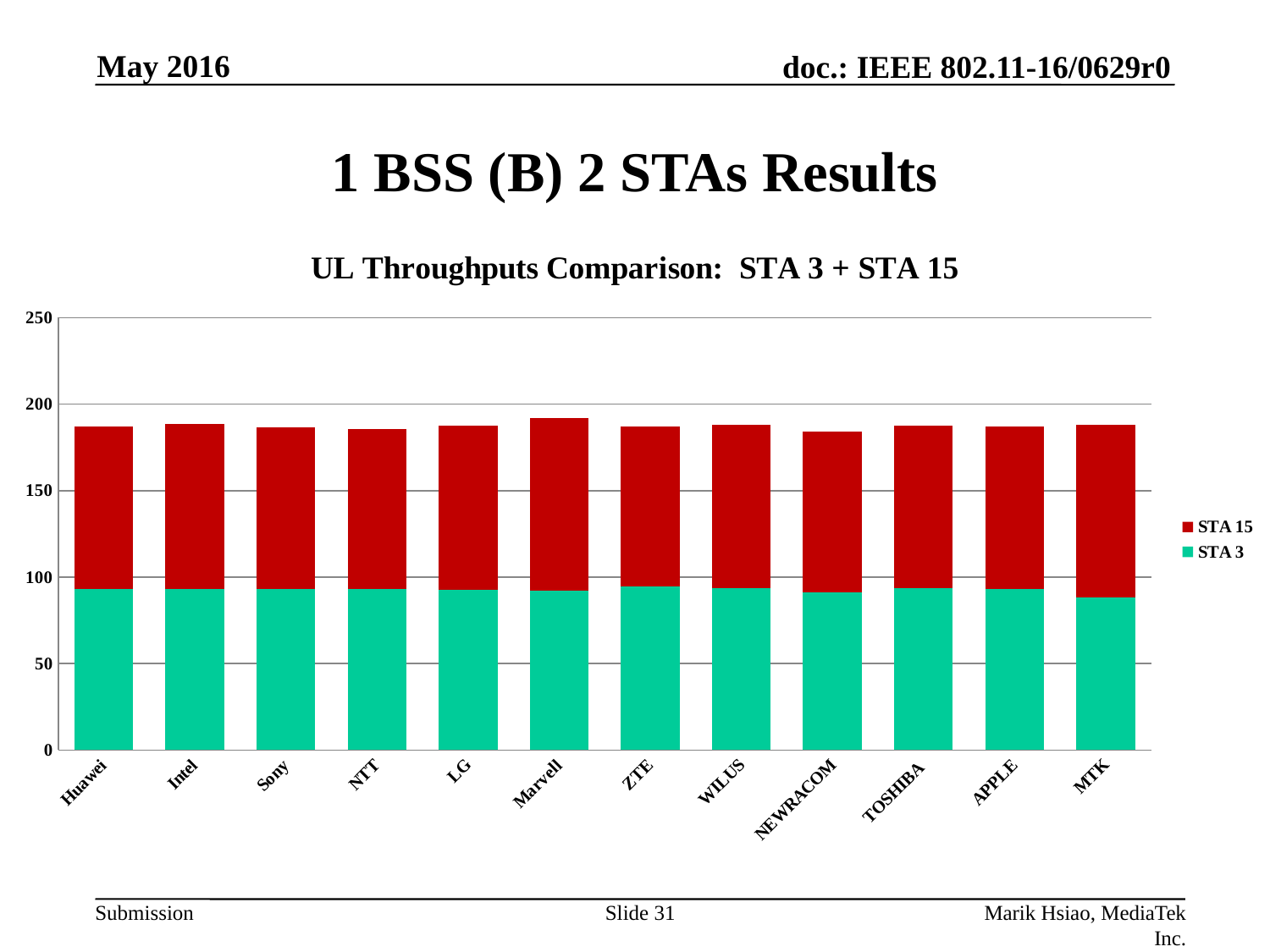
What are the two series named in the chart legend? STA 15 and STA 3 How many series does the chart legend list? 2 Is the total stacked value for Huawei greater or less than 150? greater Is the total stacked value for Marvell greater or less than 200? less Is the STA 3 value for Intel greater or less than 50? greater What is the title of the chart? UL Throughputs Comparison: STA 3 + STA 15 Which company has the lowest STA 3 value? MTK What kind of chart is shown on the slide? stacked bar chart How many companies are listed along the x axis of the chart? 12 Which company has the highest total stacked bar (STA 3 + STA 15)? Marvell